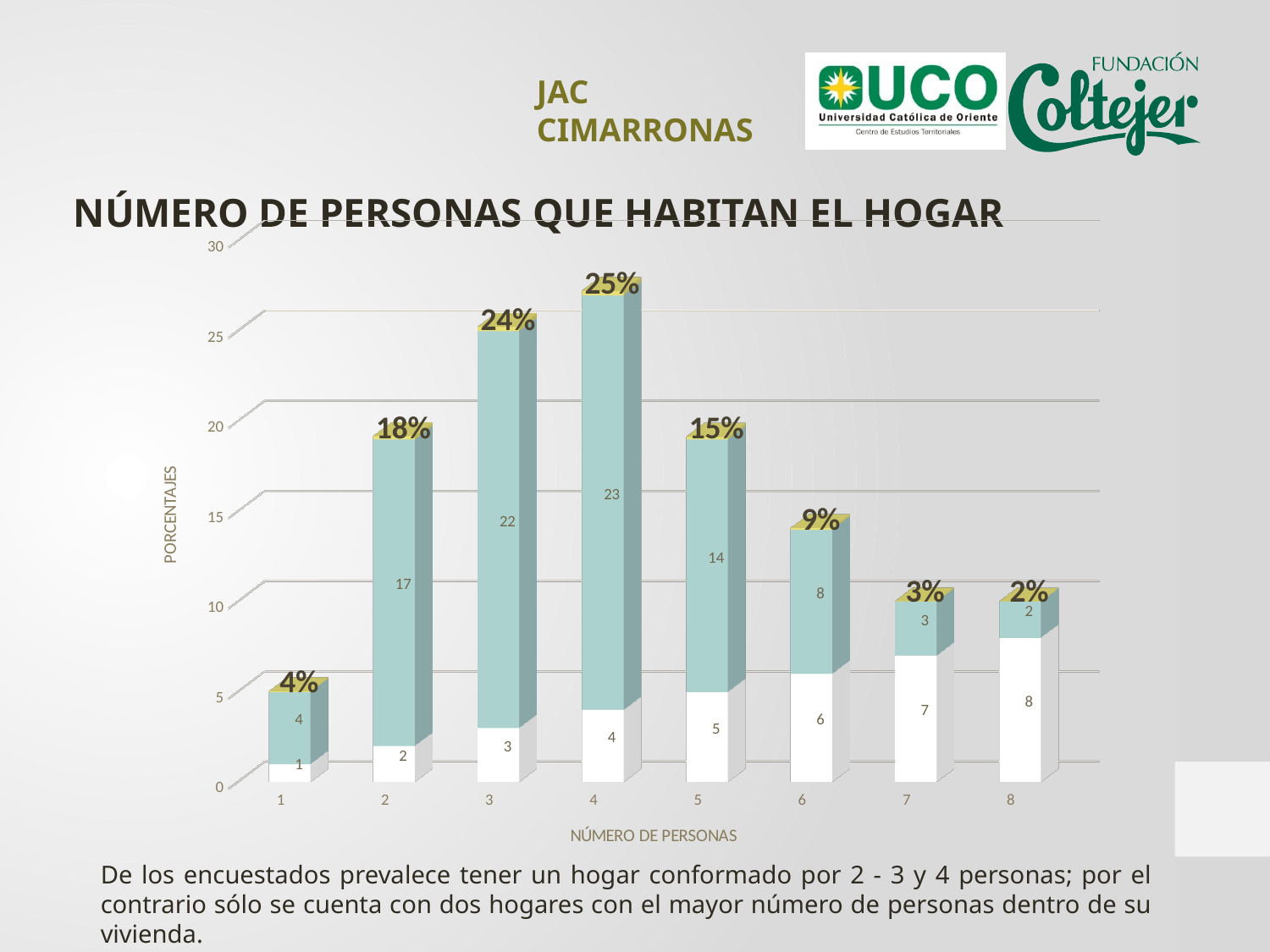
What percentage label is shown above the bar for 4 persons? 25% What kind of chart is shown on the slide? Bar chart What is the label on the vertical axis of the chart? PORCENTAJES What is the difference between the percentage labels for 3 persons and 5 persons? 9% Do the percentage labels rise or fall from 4 persons to 8 persons? Fall What percentage label is shown above the bar for 2 persons? 18% What is the value printed in the teal segment of the bar for 6 persons? 8 Which number of persons has the lowest percentage label? 8 What is the value printed in the teal segment of the bar for 3 persons? 22 Which number of persons has the highest percentage label? 4 Which has a larger percentage label: 1 person or 6 persons? 6 persons How many categories are shown on the x axis? 8